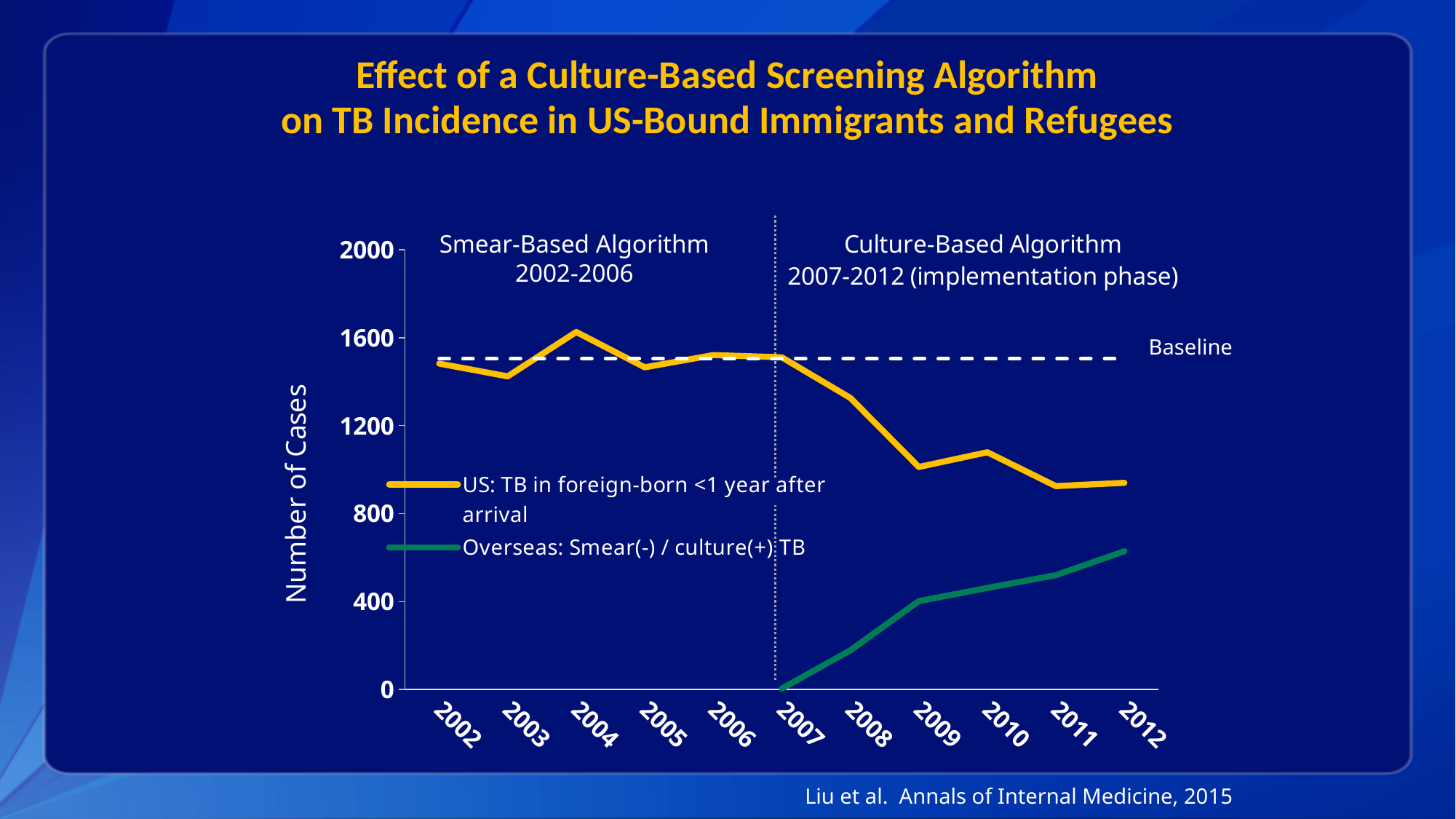
In which year is the 'Overseas: Smear(-) / culture(+) TB' series at its lowest? 2007 In which year is the 'Overseas: Smear(-) / culture(+) TB' series at its highest? 2012 Does the 'Overseas: Smear(-) / culture(+) TB' series rise or fall from 2007 to 2012? rise Is the value for 'US: TB in foreign-born <1 year after arrival' in 2009 greater or less than 1200? less In which year does the 'US: TB in foreign-born <1 year after arrival' series reach its highest value? 2004 What kind of chart is shown on the slide? line chart How many series does the legend list? 2 Is the value for 'Overseas: Smear(-) / culture(+) TB' in 2012 greater or less than 400? greater How many years are shown along the x axis? 11 Which series has the larger value in 2012, 'US: TB in foreign-born <1 year after arrival' or 'Overseas: Smear(-) / culture(+) TB'? US: TB in foreign-born <1 year after arrival Is the value for 'Overseas: Smear(-) / culture(+) TB' in 2008 greater or less than 400? less What is the label on the y axis of the chart? Number of Cases